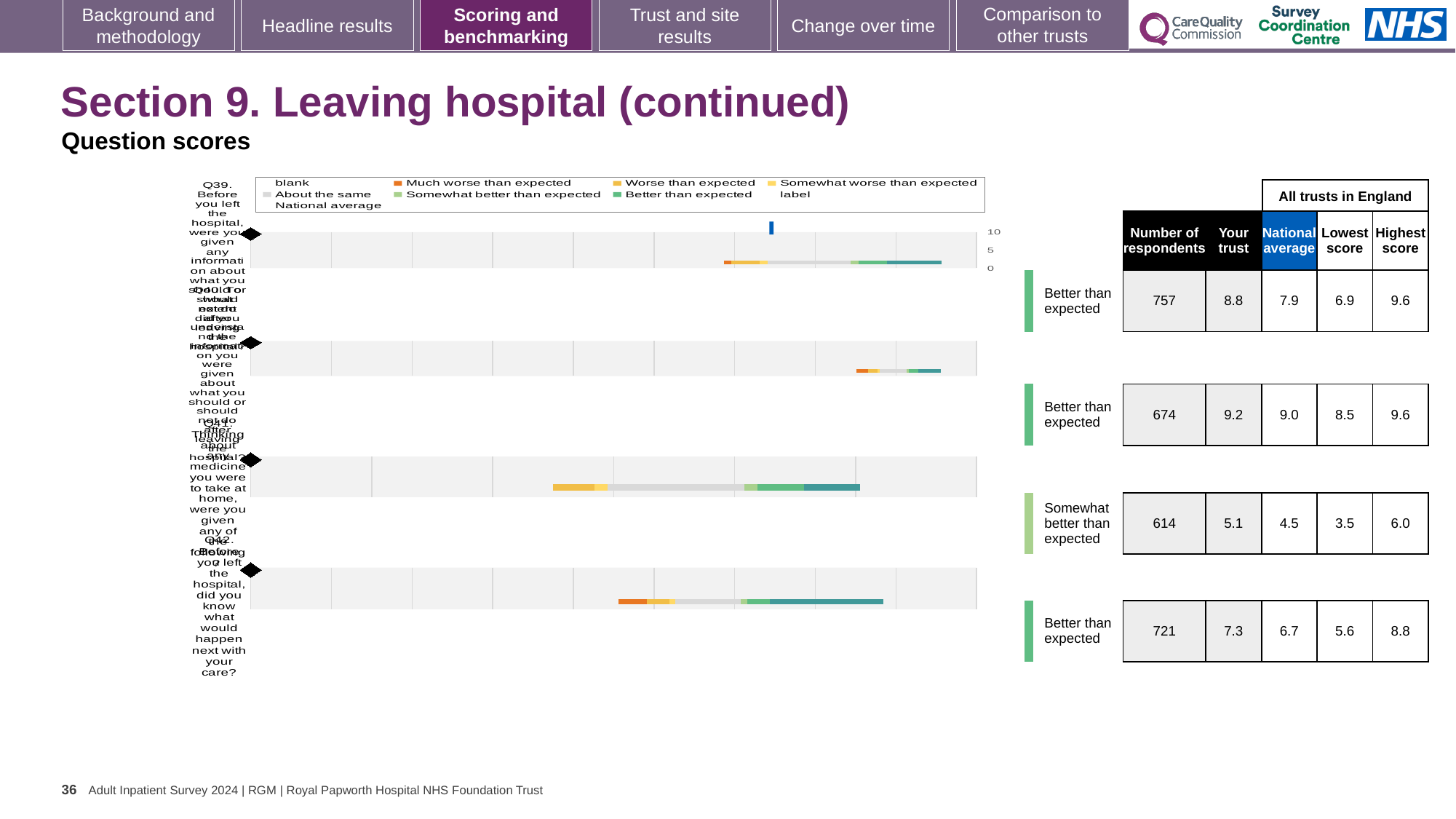
Which questions are plotted in the chart, from top to bottom? Q39, Q40, Q41, Q42 How many questions (bars) are plotted in the chart? 4 What kind of chart is used to show the question scores on this slide? bar chart What is the 'Your trust' score shown for Q41 (information about medicine side effects)? 5.1 Which of the four questions has the lowest 'Your trust' score? Q41 What is the difference between the 'Your trust' score and the national average for Q39? 0.9 What is the national average score shown for Q42 (knowing what would happen next with your care)? 6.7 What benchmark category is shown for Q41? Somewhat better than expected How many respondents are shown for Q40? 674 What is the 'Your trust' score shown for Q39 (information about what you should or should not do after leaving hospital)? 8.8 Is the 'Your trust' score for Q42 higher or lower than the national average for Q42? higher Which of the four questions has the highest 'Your trust' score? Q40